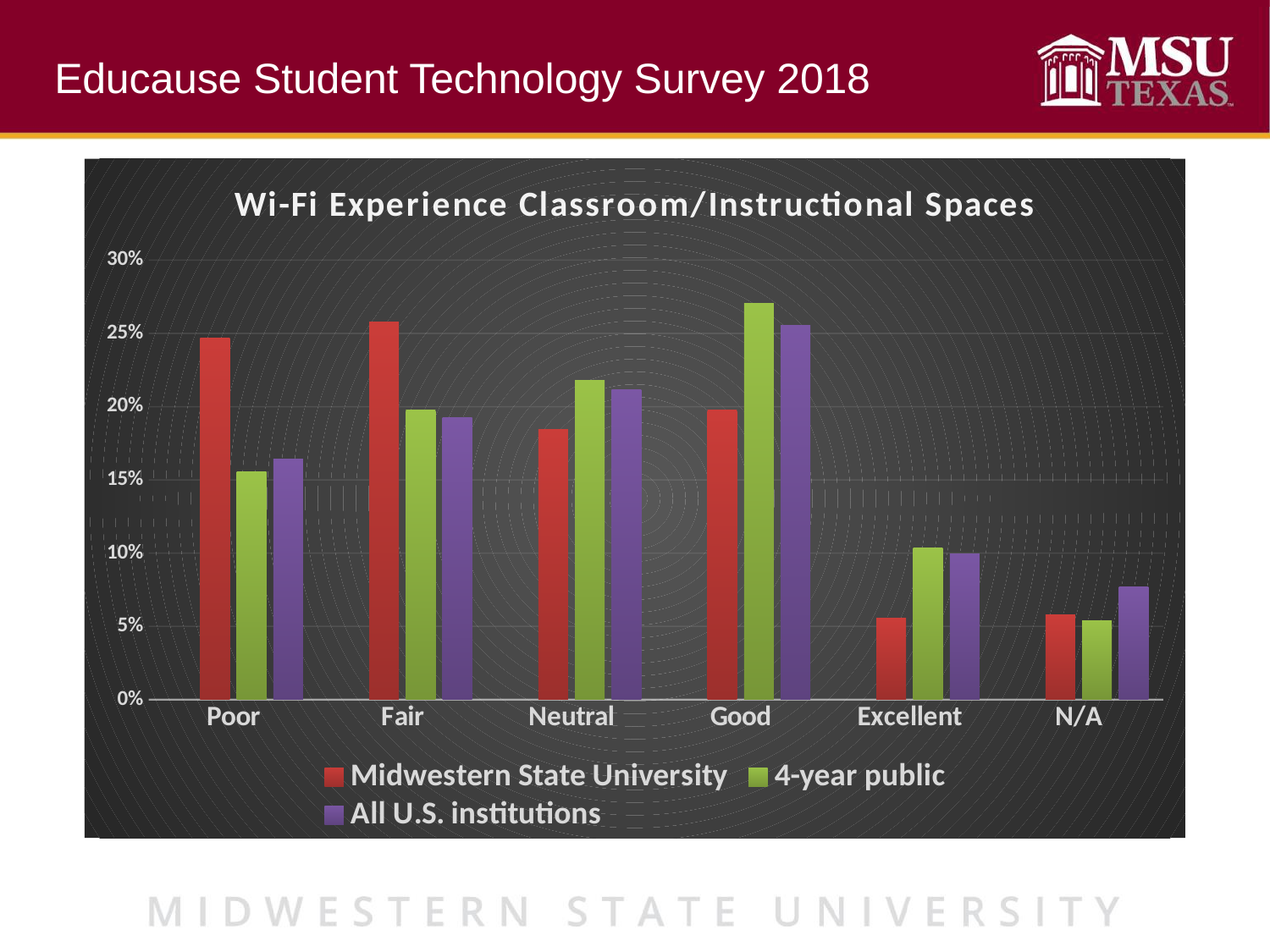
How many categories are shown on the x axis? 6 In the Good category, which is larger: Midwestern State University or 4-year public? 4-year public For the 4-year public series, which category has the highest value? Good Is the All U.S. institutions value for N/A greater or less than 10%? less Which colour represents Midwestern State University in the chart? red How many series does the legend list? 3 Is the 4-year public value for Good greater or less than 25%? greater Is the Midwestern State University value for Poor greater or less than 20%? greater For the Midwestern State University series, which category has the highest value? Fair What kind of chart is shown on the slide? bar chart What is the title of the chart? Wi-Fi Experience Classroom/Instructional Spaces For the 4-year public series, which category has the lowest value? N/A